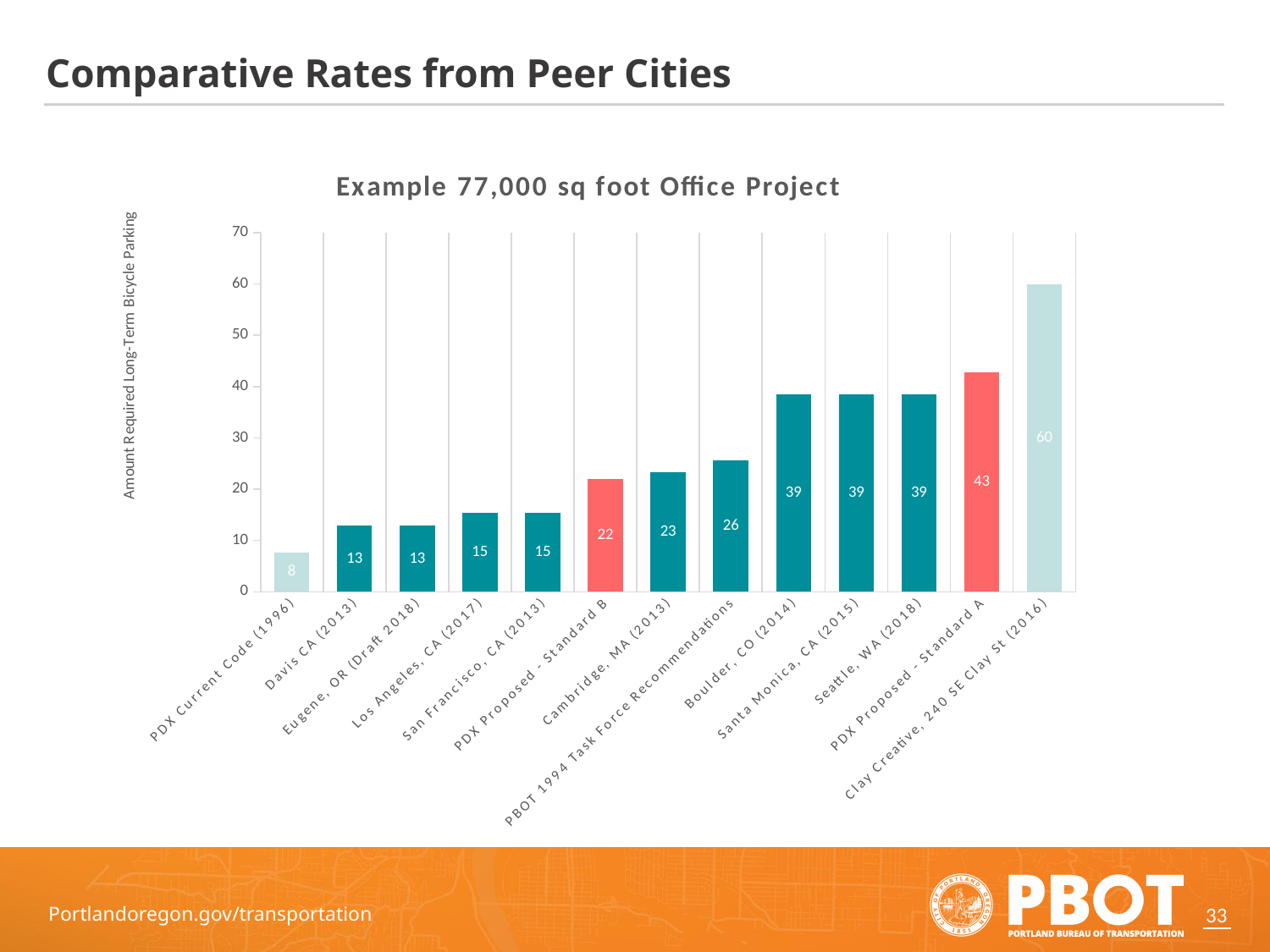
How many categories are shown on the x axis? 13 Which category has the lowest value? PDX Current Code (1996) Which category has the highest value? Clay Creative, 240 SE Clay St (2016) What is the title of the chart? Example 77,000 sq foot Office Project Is the value for Boulder, CO (2014) greater or less than 30? greater What is the value for Cambridge, MA (2013)? 23 Which is larger, the value for Seattle, WA (2018) or the value for Cambridge, MA (2013)? Seattle, WA (2018) What is the value for PDX Proposed - Standard A? 43 What is the value for PBOT 1994 Task Force Recommendations? 26 What is the difference between the values for PDX Proposed - Standard A and PDX Proposed - Standard B? 21 What kind of chart is shown on the slide? bar chart What is the difference between the values for Clay Creative, 240 SE Clay St (2016) and PDX Current Code (1996)? 52